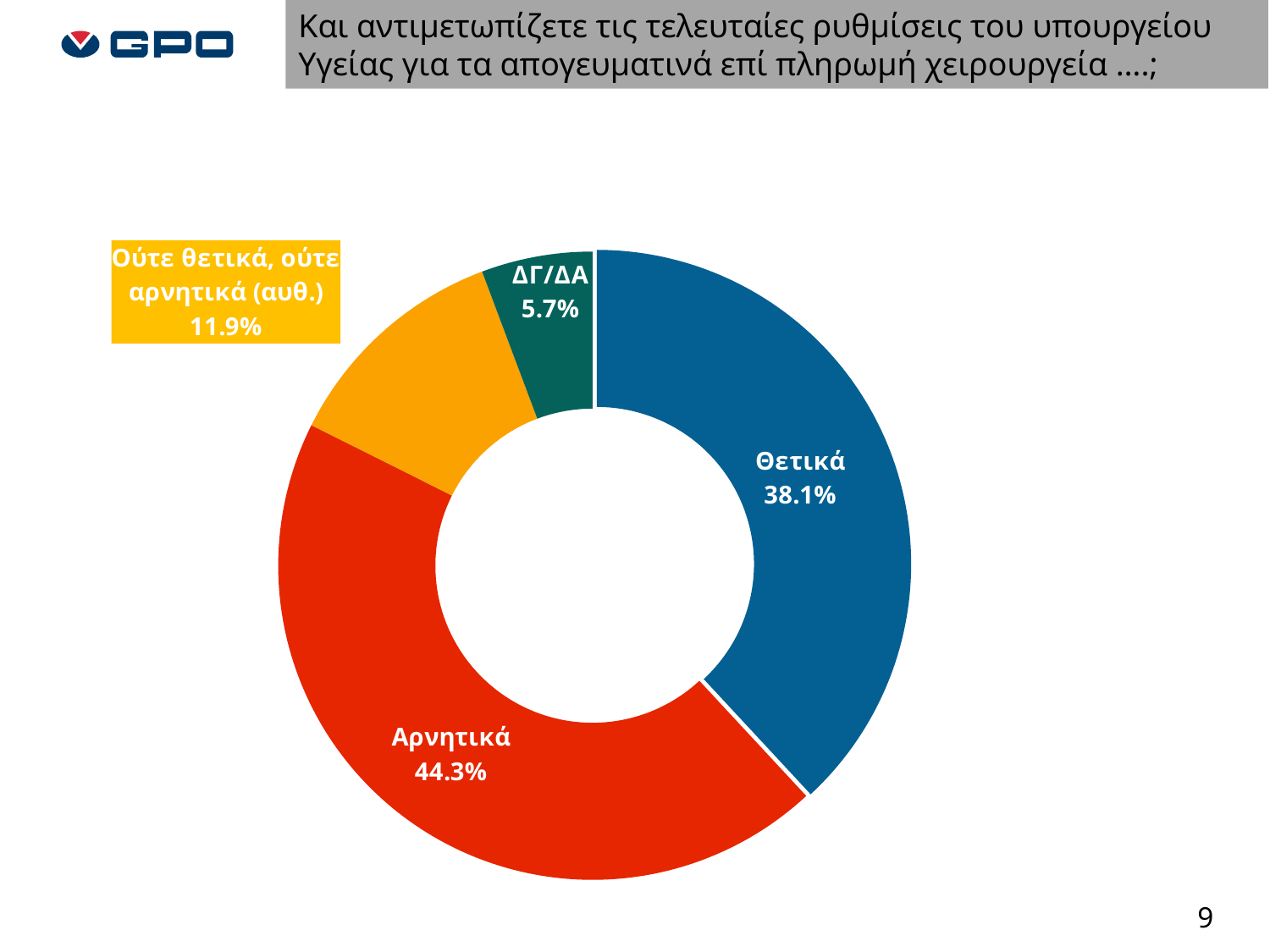
What colour is the Αρνητικά segment? Red What is the value shown for ΔΓ/ΔΑ? 5.7% What is the difference in percentage points between Αρνητικά and Θετικά? 6.2 What is the combined share of Θετικά and Αρνητικά? 82.4% What is the value shown for Ούτε θετικά, ούτε αρνητικά (αυθ.)? 11.9% What percentage of respondents answered Θετικά? 38.1% What kind of chart is shown on the slide? Doughnut (pie) chart What percentage of respondents answered Αρνητικά? 44.3% Which category has the smallest share of the chart? ΔΓ/ΔΑ Which category has the largest share of the chart? Αρνητικά How many categories are shown in the chart? 4 Which is larger, Θετικά or Ούτε θετικά, ούτε αρνητικά (αυθ.)? Θετικά